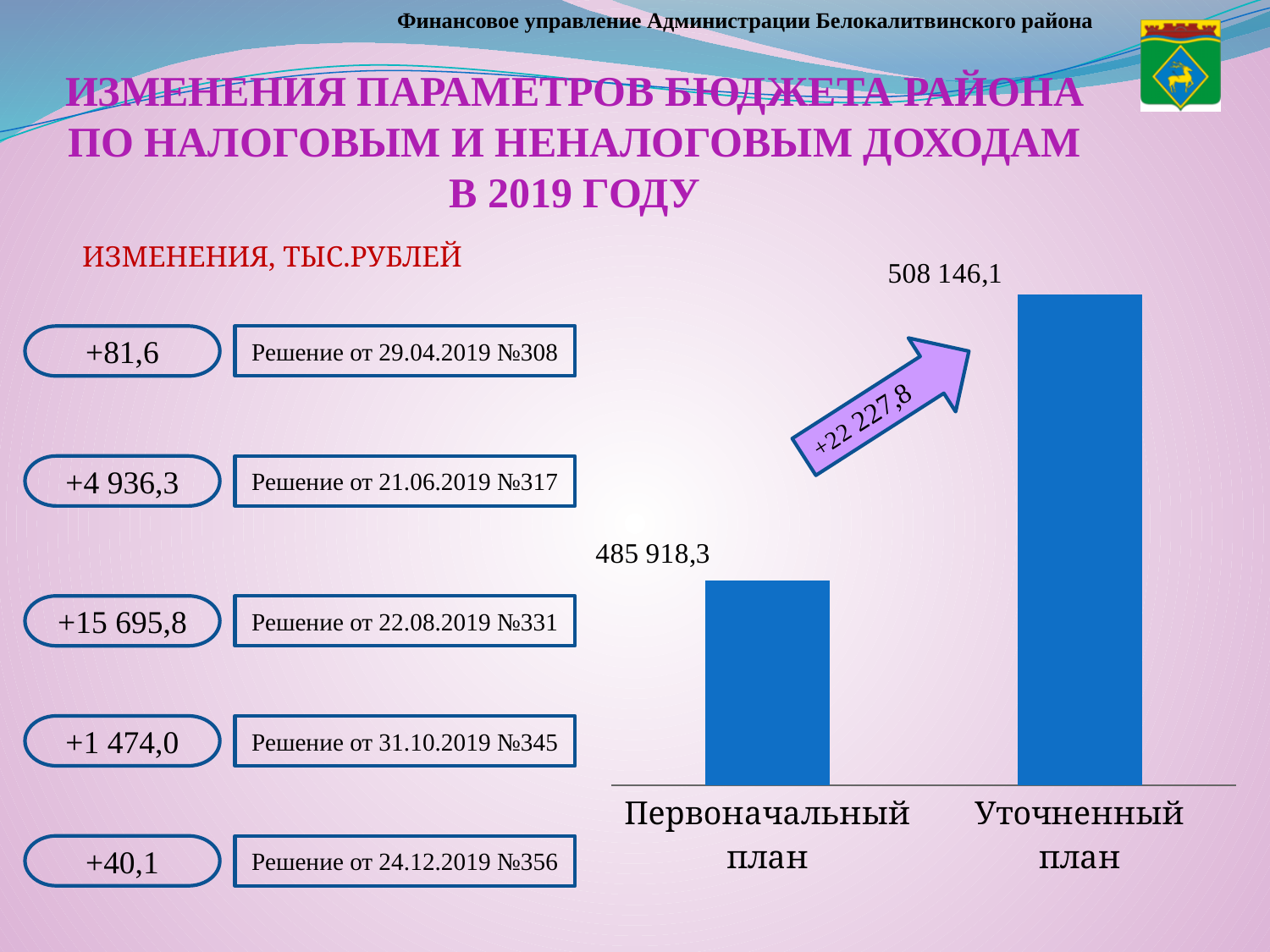
What change is written on the arrow between the two bars? +22 227,8 What colour are the bars in the chart? blue Which category has the highest value? Уточненный план What is the value for Первоначальный план? 485 918,3 How many bars are plotted in the chart? 2 What kind of chart is shown on the slide? bar chart What is the value for Уточненный план? 508 146,1 Which category has the higher value, Первоначальный план or Уточненный план? Уточненный план Which category has the lowest value? Первоначальный план Do the values rise or fall from Первоначальный план to Уточненный план? rise What is the difference between the value for Уточненный план and the value for Первоначальный план? 22 227,8